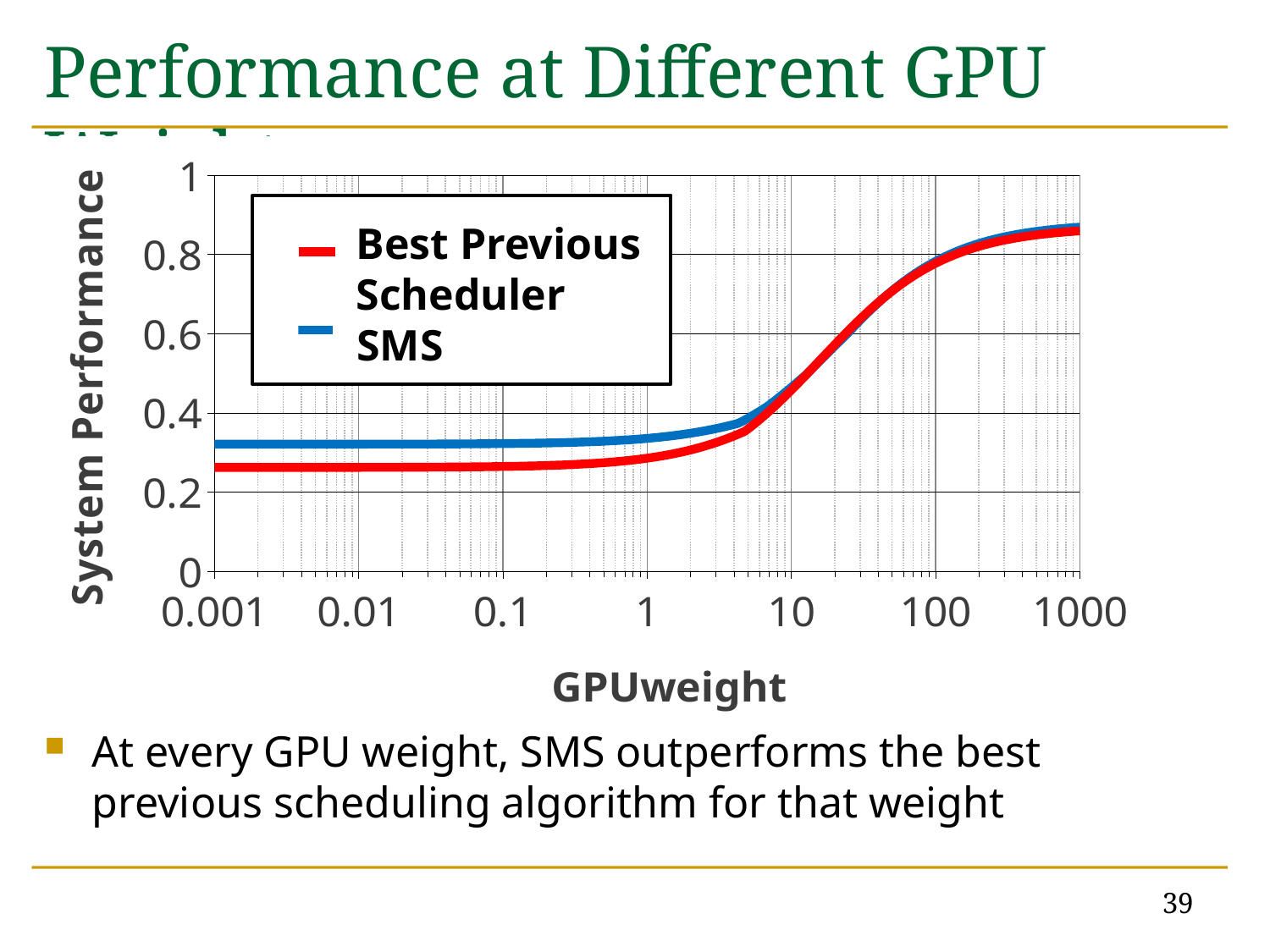
What is the title of the x axis? GPUweight At a GPUweight of 0.01, which series has the lower System Performance, SMS or Best Previous Scheduler? Best Previous Scheduler Do the values for SMS rise or fall as GPUweight increases along the x axis? rise What kind of chart is shown on the slide? line chart Is the System Performance for Best Previous Scheduler at a GPUweight of 0.001 greater or less than 0.2? greater Do the values for Best Previous Scheduler rise or fall as GPUweight increases along the x axis? rise Is the System Performance for SMS at a GPUweight of 0.001 greater or less than 0.4? less How many series does the legend list? 2 Which series is drawn in red? Best Previous Scheduler Is the System Performance for SMS at a GPUweight of 1000 greater or less than 0.8? greater At a GPUweight of 0.001, which series has the higher System Performance, SMS or Best Previous Scheduler? SMS